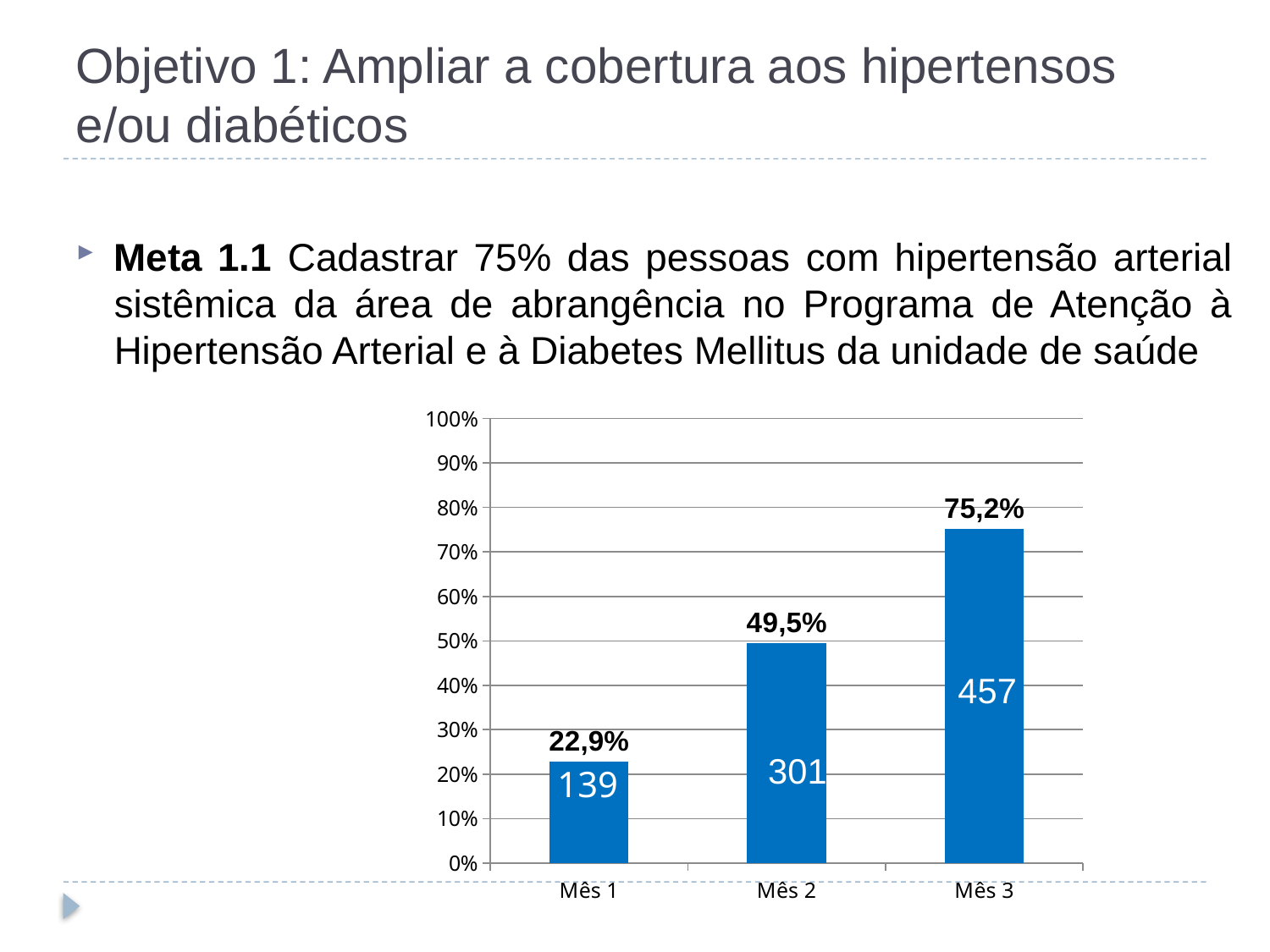
What is the percentage value shown for Mês 1? 22,9% What number is printed inside the bar for Mês 1? 139 How many months (categories) are shown on the x axis? 3 Which is larger, the value for Mês 2 or the value for Mês 1? Mês 2 What is the difference in percentage points between Mês 3 and Mês 2? 25,7 Which month has the lowest percentage? Mês 1 Which month has the highest percentage? Mês 3 Do the values rise or fall from Mês 1 to Mês 3? Rise What number is printed inside the bar for Mês 3? 457 What kind of chart is shown on the slide? Bar chart What is the percentage value shown for Mês 3? 75,2% What is the percentage value shown for Mês 2? 49,5%